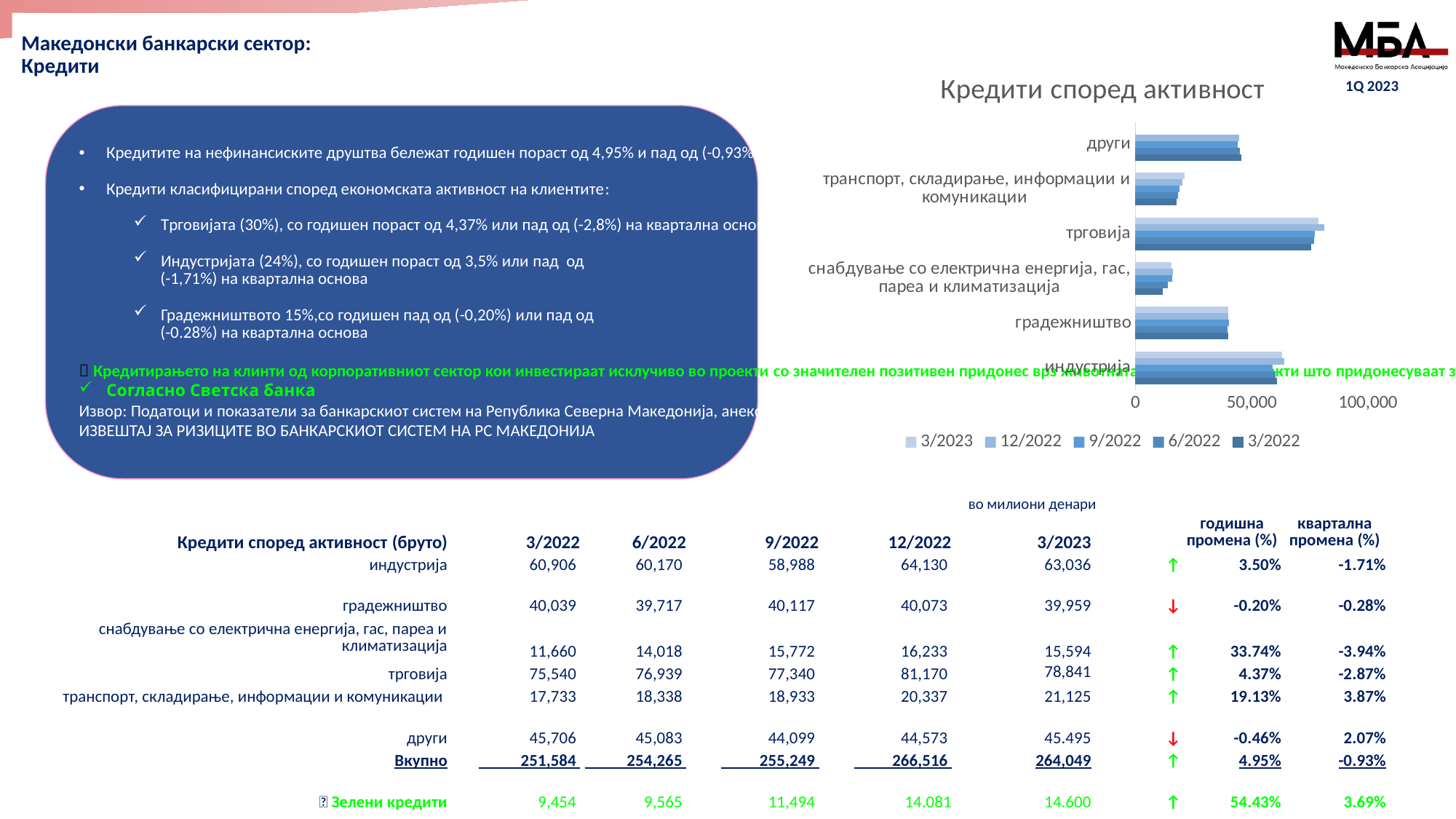
What is the first entry in the legend of the 'Кредити според активност' chart? 3/2023 How many categories are shown on the 'Кредити според активност' chart? 6 On the 'Кредити според активност' chart, is the value for трговија greater or less than 50,000? greater How many series does the legend of the 'Кредити според активност' chart list? 5 Which category has the shortest bars on the 'Кредити според активност' chart? снабдување со електрична енергија, гас, пареа и климатизација On the 'Кредити според активност' chart, is the value for градежништво greater or less than 50,000? less According to the table, what is the value for трговија in 12/2022? 81,170 Which category has the longest bars on the 'Кредити според активност' chart? трговија According to the table, what is the difference between трговија in 12/2022 and in 3/2023? 2,329 On the 'Кредити според активност' chart, which is larger: индустрија or градежништво? индустрија According to the table, what is the value for индустрија in 3/2023? 63,036 What kind of chart is 'Кредити според активност'? bar chart